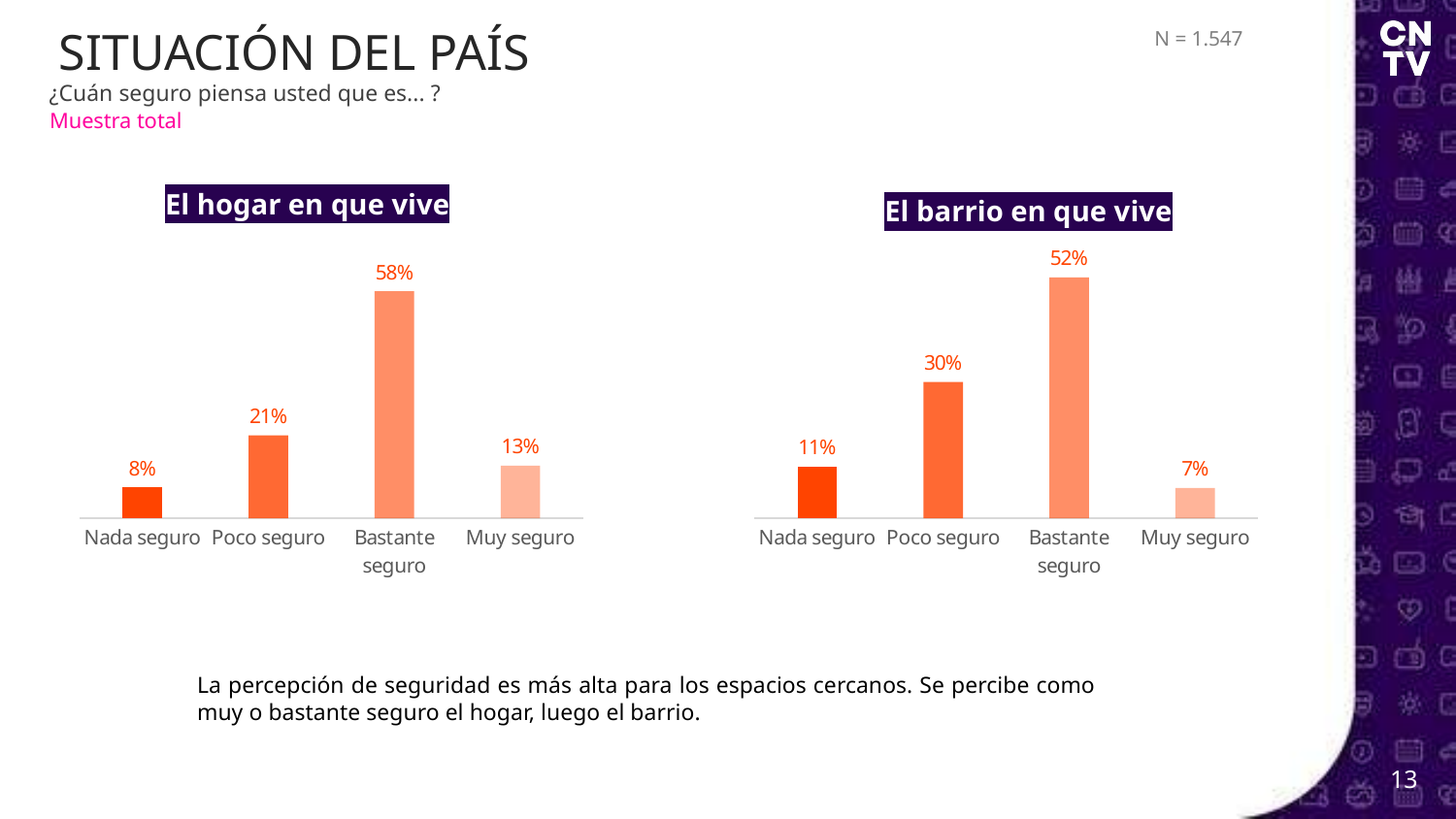
In the 'El hogar en que vive' chart, what is the combined value of Bastante seguro and Muy seguro? 71% What type of chart is 'El barrio en que vive'? Bar chart In the 'El hogar en que vive' chart, what is the value for Bastante seguro? 58% In the 'El hogar en que vive' chart, what is the difference between Bastante seguro and Poco seguro? 37% In the 'El barrio en que vive' chart, which category has the lowest value? Muy seguro In the 'El hogar en que vive' chart, which category has the lowest value? Nada seguro What is the sample size (N) shown on the slide? 1.547 In the 'El barrio en que vive' chart, what is the value for Poco seguro? 30% In the 'El barrio en que vive' chart, which category has the highest value? Bastante seguro In the 'El hogar en que vive' chart, how many categories are shown? 4 In the 'El barrio en que vive' chart, what is the difference between Nada seguro and Muy seguro? 4% Which is larger: Muy seguro in the 'El hogar en que vive' chart or Muy seguro in the 'El barrio en que vive' chart? El hogar en que vive